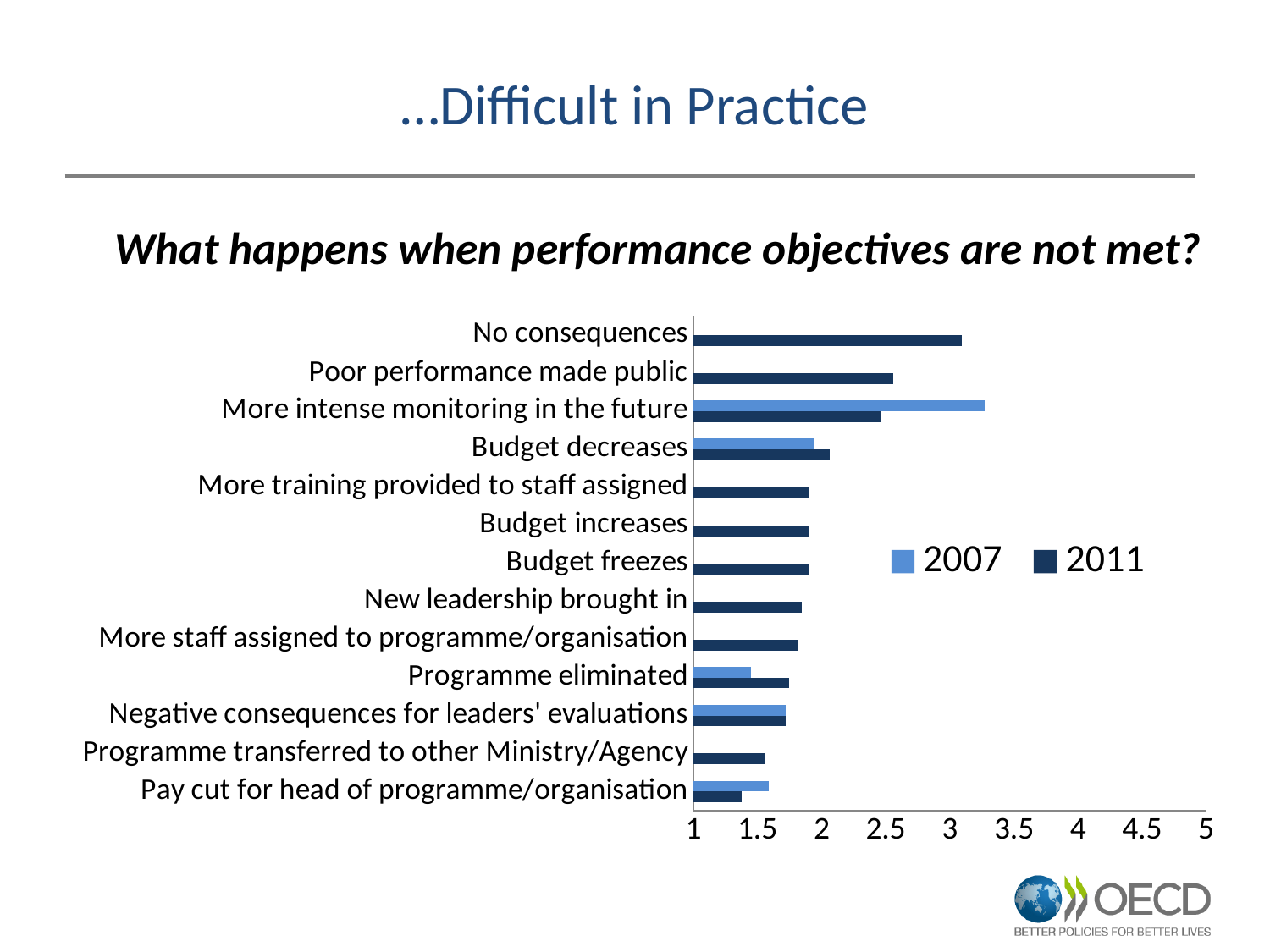
What question does the chart's heading ask? What happens when performance objectives are not met? For Programme eliminated, which series has the larger value, 2007 or 2011? 2011 What kind of chart is shown on the slide? bar chart Is the 2007 value for More intense monitoring in the future greater or less than 3? greater Is the 2011 value for Pay cut for head of programme/organisation greater or less than 1.5? less Is the 2011 value for No consequences greater or less than 3? greater How many categories are shown on the chart? 13 Which category has the highest 2007 value? More intense monitoring in the future For More intense monitoring in the future, which series has the larger value, 2007 or 2011? 2007 Which category has the lowest 2011 value? Pay cut for head of programme/organisation Which category has the highest 2011 value? No consequences How many series does the legend list? 2